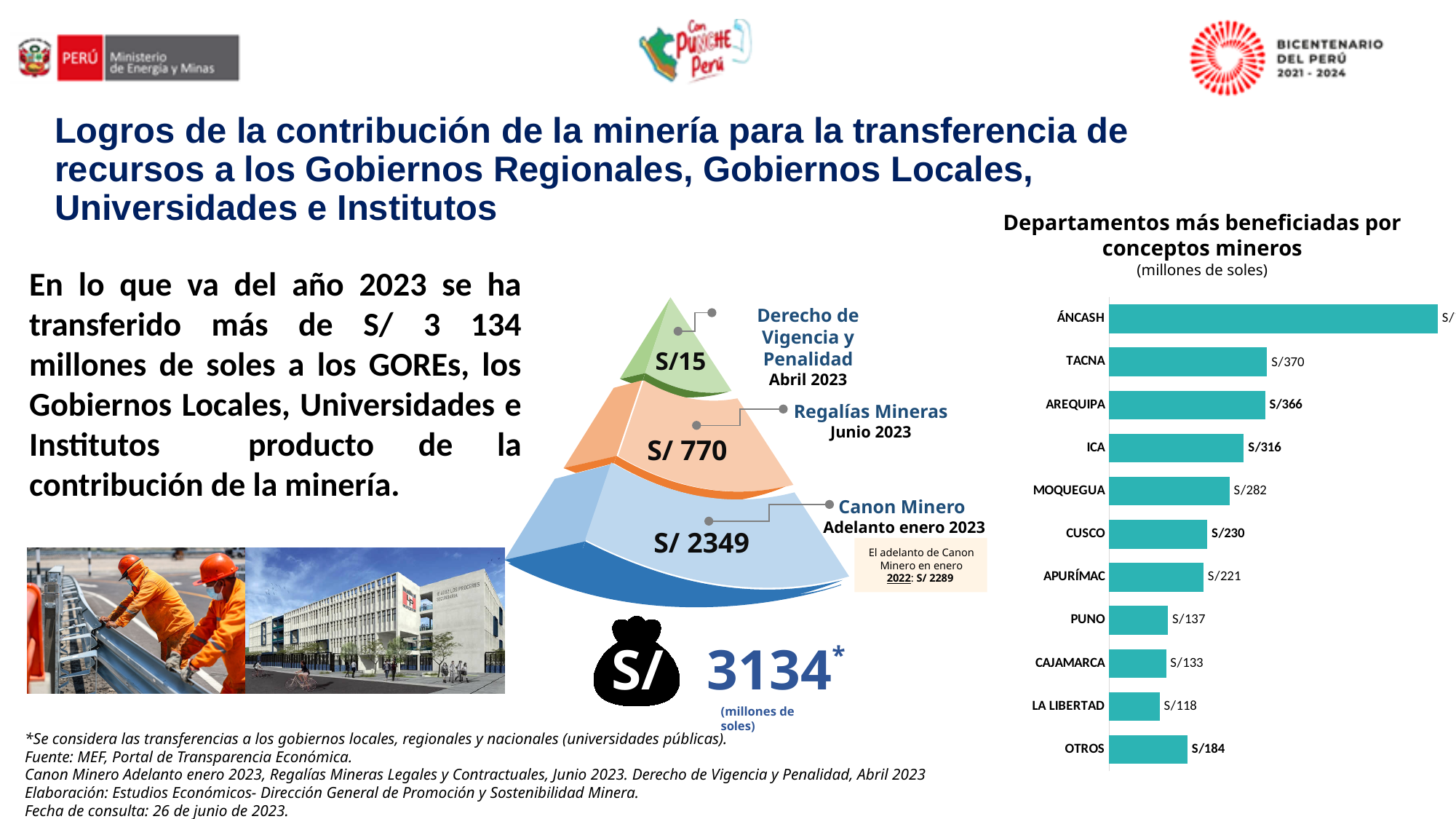
In the 'Departamentos más beneficiadas por conceptos mineros' chart, what is the difference between the values for ICA and MOQUEGUA? S/34 In the 'Departamentos más beneficiadas por conceptos mineros' chart, what is the value for CAJAMARCA? S/133 In the 'Departamentos más beneficiadas por conceptos mineros' chart, which is larger, the value for PUNO or the value for OTROS? OTROS In the 'Departamentos más beneficiadas por conceptos mineros' chart, what is the difference between the values for CUSCO and APURÍMAC? S/9 How many departments (bars) are shown in the 'Departamentos más beneficiadas por conceptos mineros' chart? 11 In the 'Departamentos más beneficiadas por conceptos mineros' chart, which department has the longest bar? ÁNCASH In what unit are the values of the 'Departamentos más beneficiadas por conceptos mineros' chart expressed, according to its subtitle? millones de soles In the 'Departamentos más beneficiadas por conceptos mineros' chart, what is the value for MOQUEGUA? S/282 In the 'Departamentos más beneficiadas por conceptos mineros' chart, what is the value for OTROS? S/184 What kind of chart is 'Departamentos más beneficiadas por conceptos mineros'? Bar chart In the 'Departamentos más beneficiadas por conceptos mineros' chart, which department has the lowest value? LA LIBERTAD In the 'Departamentos más beneficiadas por conceptos mineros' chart, what is the value for TACNA? S/370